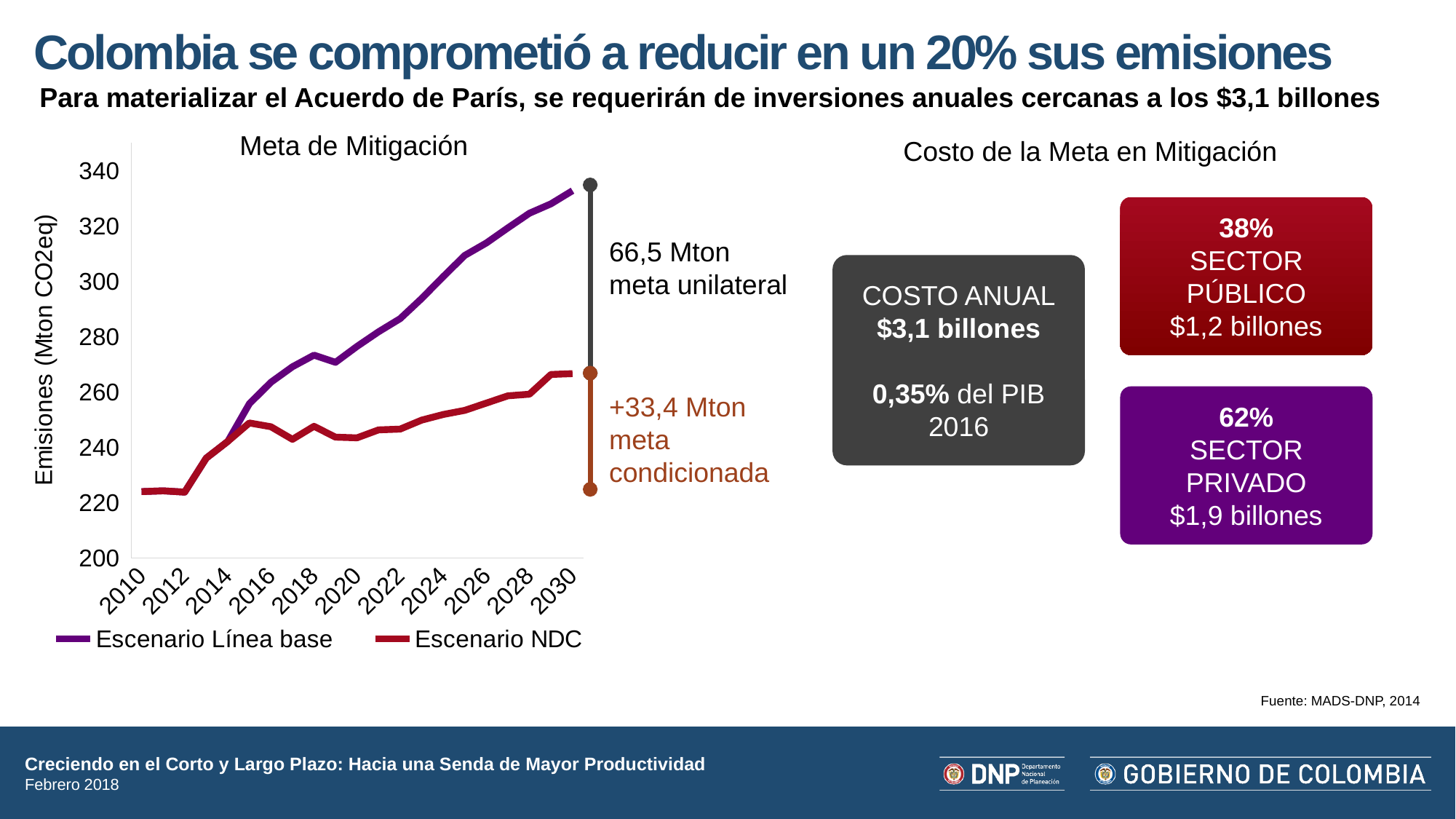
In the "Meta de Mitigación" chart, which series is higher in 2030, Escenario Línea base or Escenario NDC? Escenario Línea base In the "Meta de Mitigación" chart, does the Escenario Línea base series rise or fall from 2010 to 2030? rise What kind of chart is "Meta de Mitigación"? line chart What are the two series named in the legend of the "Meta de Mitigación" chart? Escenario Línea base and Escenario NDC What is the y-axis label of the "Meta de Mitigación" chart? Emisiones (Mton CO2eq) In the "Meta de Mitigación" chart, what gap in Mton is labelled as the "meta unilateral" between the two lines in 2030? 66,5 Mton In the "Meta de Mitigación" chart, is the value for Escenario Línea base in 2024 greater or less than 280? greater In the "Meta de Mitigación" chart, is the value for Escenario Línea base in 2030 greater or less than 320? greater In the "Meta de Mitigación" chart, is the value for Escenario NDC in 2030 greater or less than 280? less How many series does the legend of the "Meta de Mitigación" chart list? 2 In the "Meta de Mitigación" chart, which series is higher in 2020, Escenario Línea base or Escenario NDC? Escenario Línea base